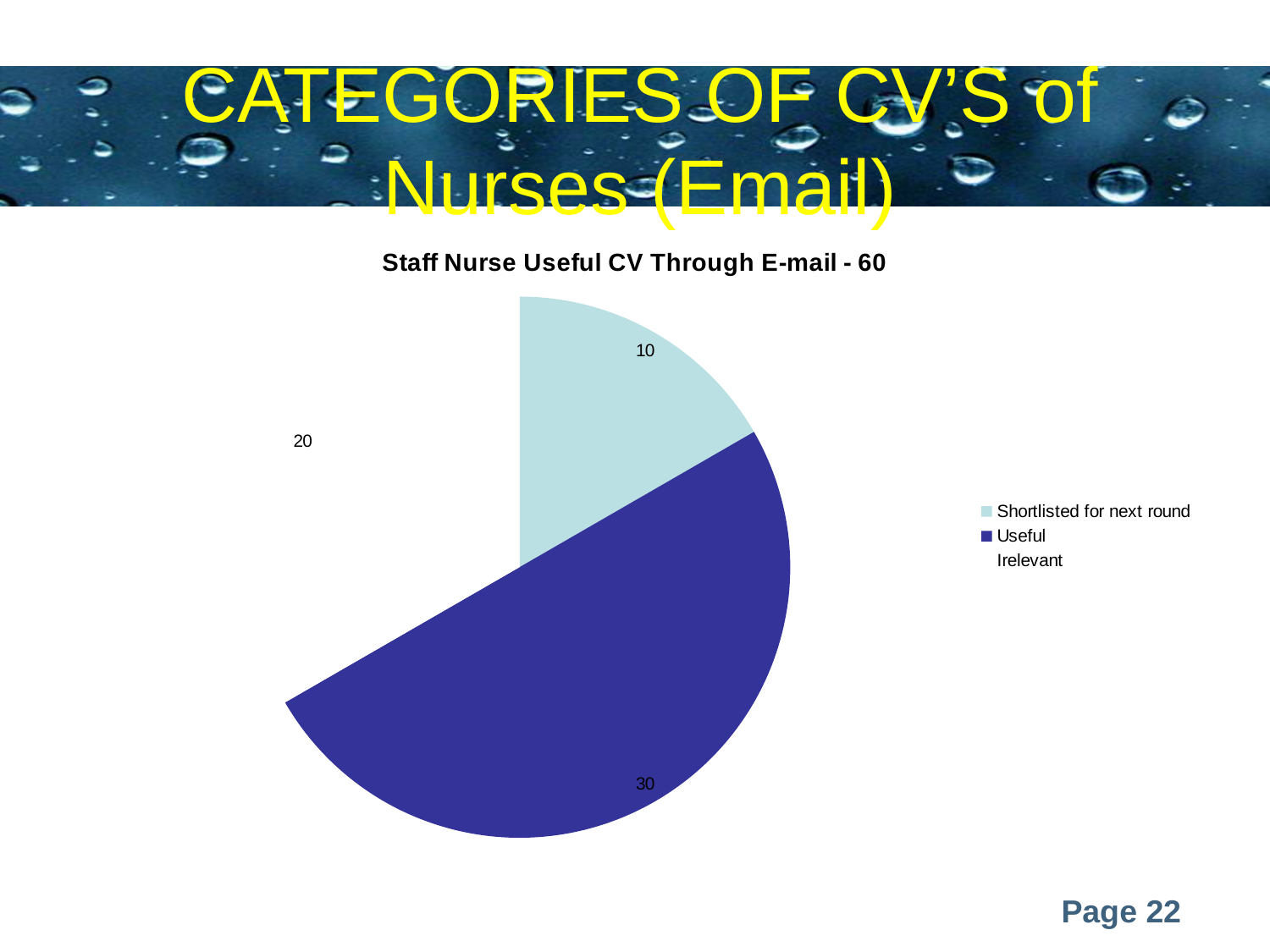
What is the total of all the slices in the pie? 60 What is the title of the chart? Staff Nurse Useful CV Through E-mail - 60 What kind of chart is shown on the slide? Pie chart What is the difference between the Useful value and the Shortlisted for next round value? 20 What is the value for the Useful slice? 30 What is the value for the Irelevant slice? 20 What is the value for the Shortlisted for next round slice? 10 Which category has the largest slice? Useful Which is larger, the Irelevant value or the Shortlisted for next round value? Irelevant Which category has the smallest slice? Shortlisted for next round What share of the pie does the Useful slice represent? 50% How many categories does the legend list? 3